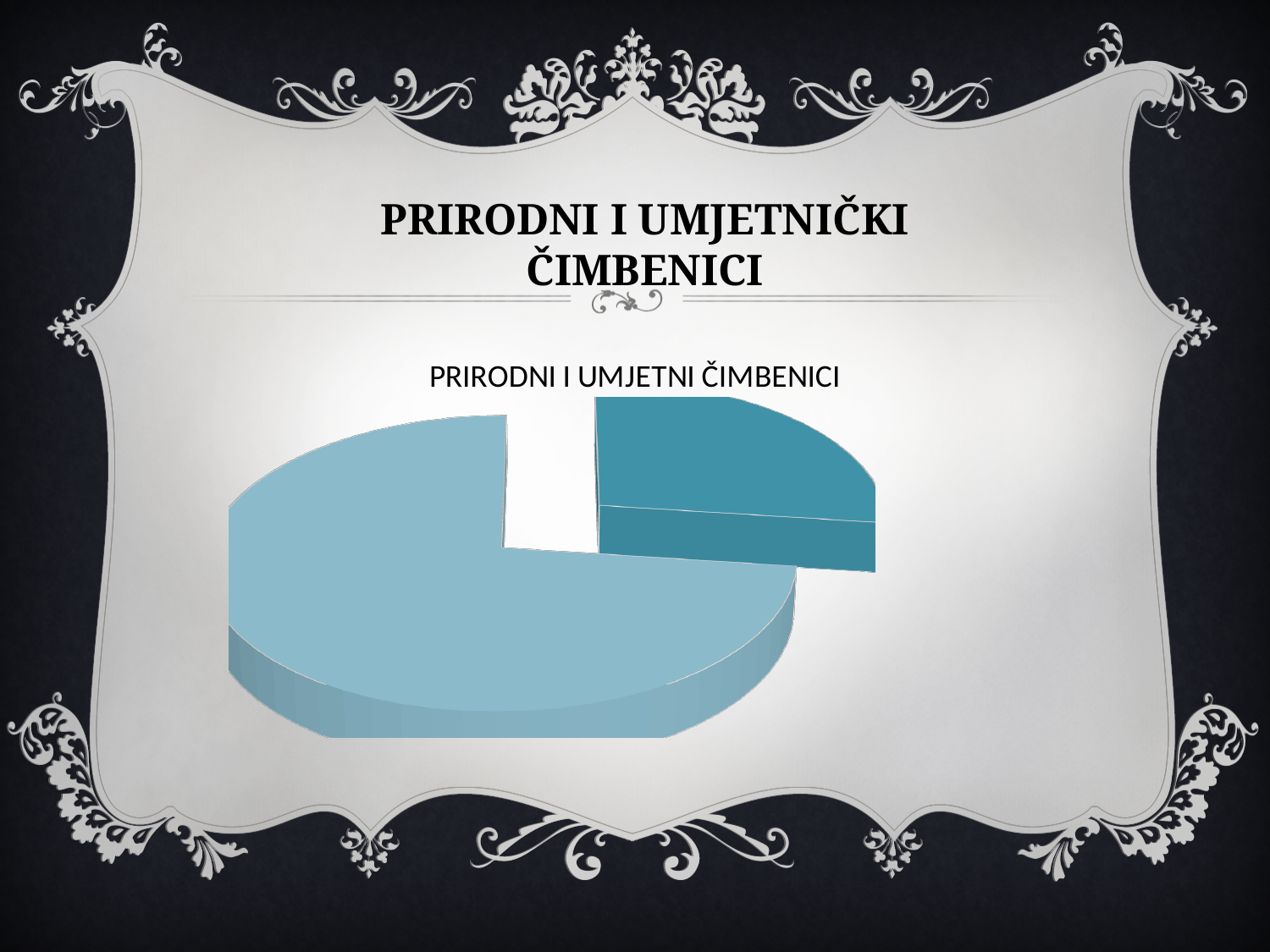
Which slice of the pie chart is larger, the light blue one or the dark teal one? the light blue one What kind of chart is shown on the slide? pie chart Is the chart drawn in 3D or flat 2D style? 3D How many slices does the pie chart have? 2 Is the dark teal slice more or less than half of the pie? less What is the title of the chart? PRIRODNI I UMJETNI ČIMBENICI